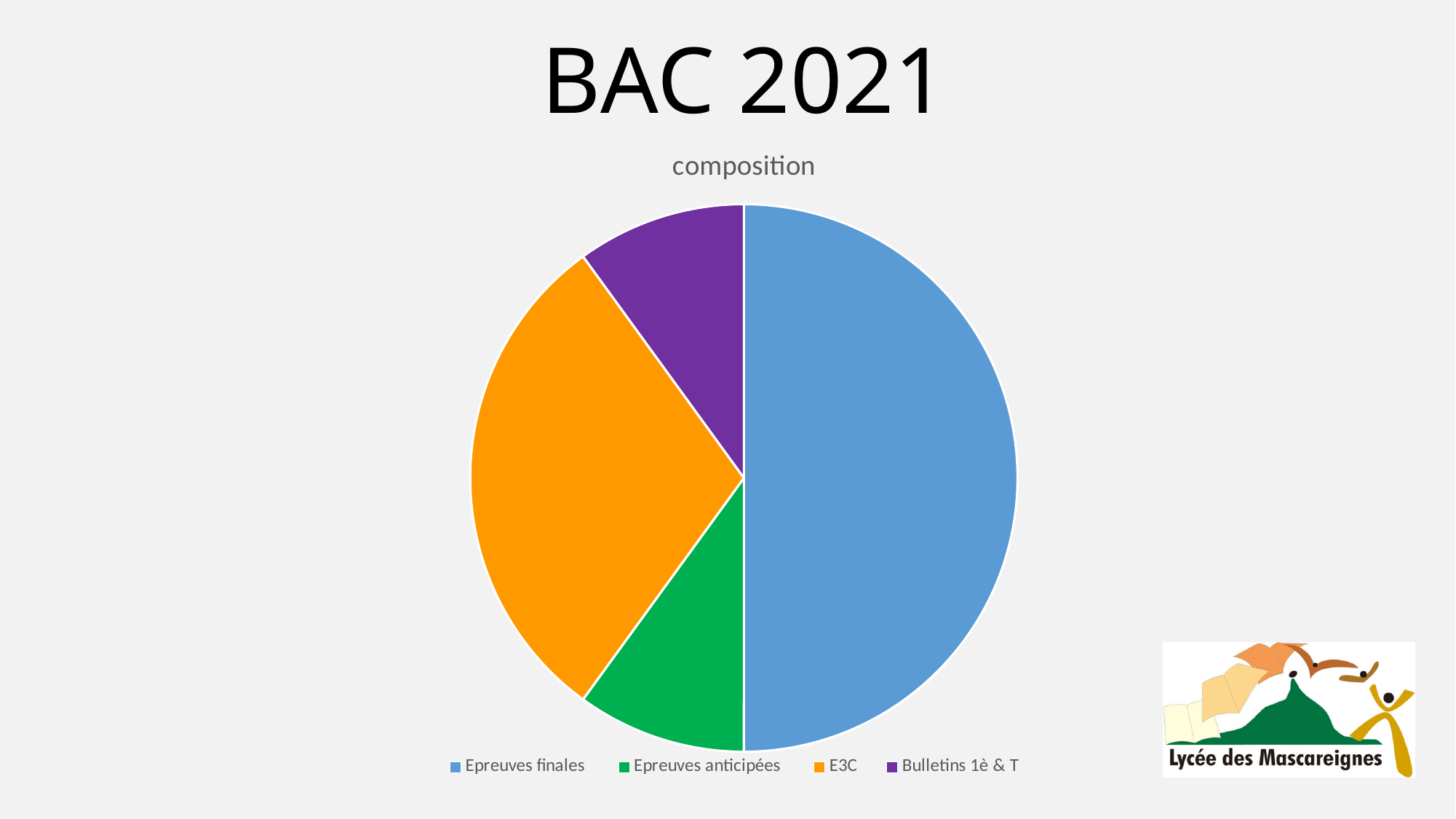
Which slice is larger, Epreuves finales or E3C? Epreuves finales Which slice is larger, E3C or Bulletins 1è & T? E3C Which slice is larger, E3C or Epreuves anticipées? E3C Which category has the largest slice of the pie chart? Epreuves finales What is the title of the pie chart? composition How many entries does the legend of the pie chart list? 4 What kind of chart is shown on the slide? pie chart How many slices does the pie chart have? 4 What colour is the E3C slice in the pie chart? orange